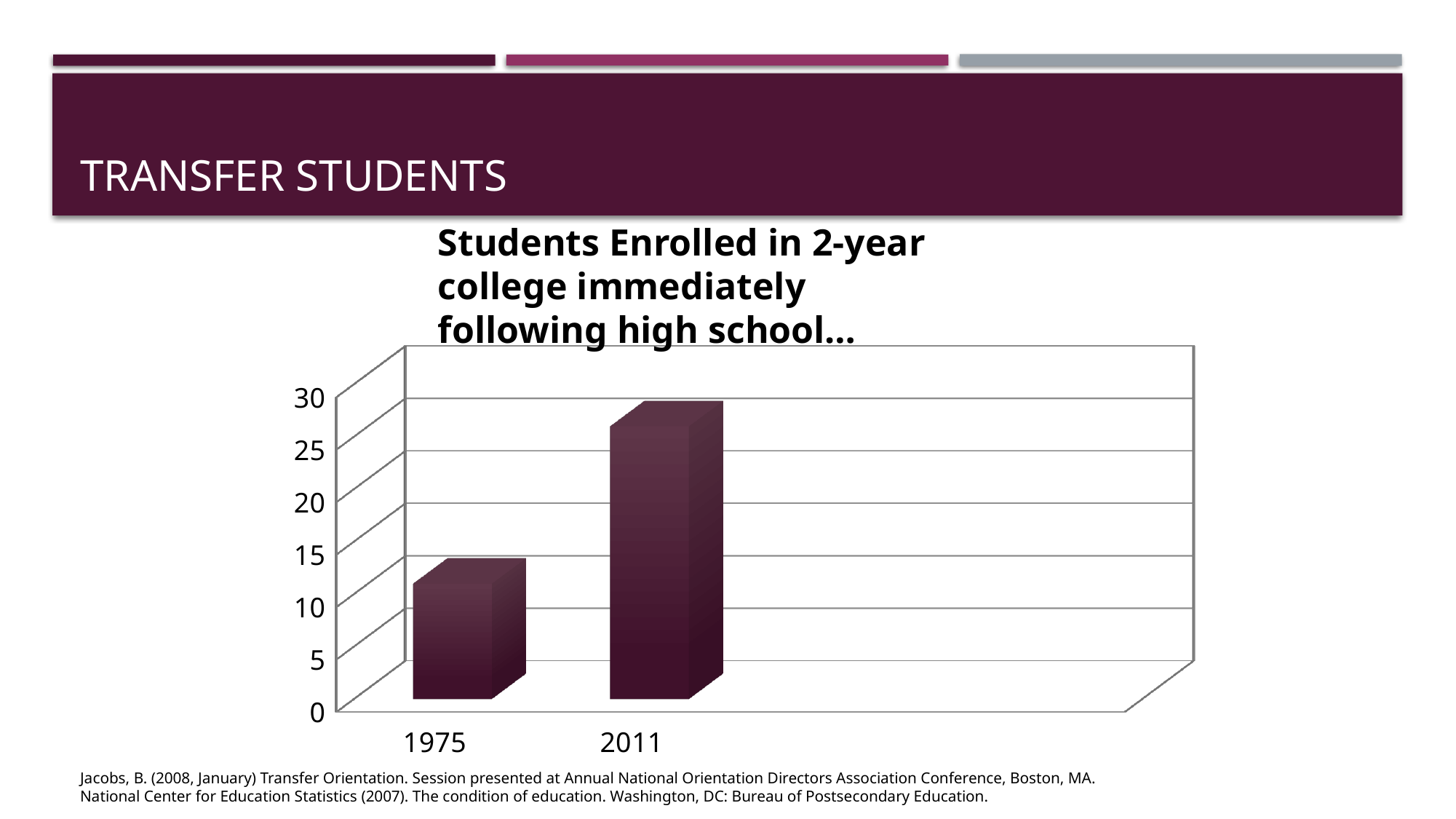
Is the value for 1975 greater or less than 20? less What kind of chart is shown on the slide? bar chart Which is larger, the value for 1975 or the value for 2011? 2011 How many categories are plotted on the x axis? 2 Is the value for 2011 greater or less than 30? less Which year has the lowest bar? 1975 Which year has the highest bar? 2011 What is the title of the chart? Students Enrolled in 2-year college immediately following high school… What is the highest value shown on the vertical axis? 30 Is the value for 1975 greater or less than 10? greater Do the values rise or fall from 1975 to 2011? rise